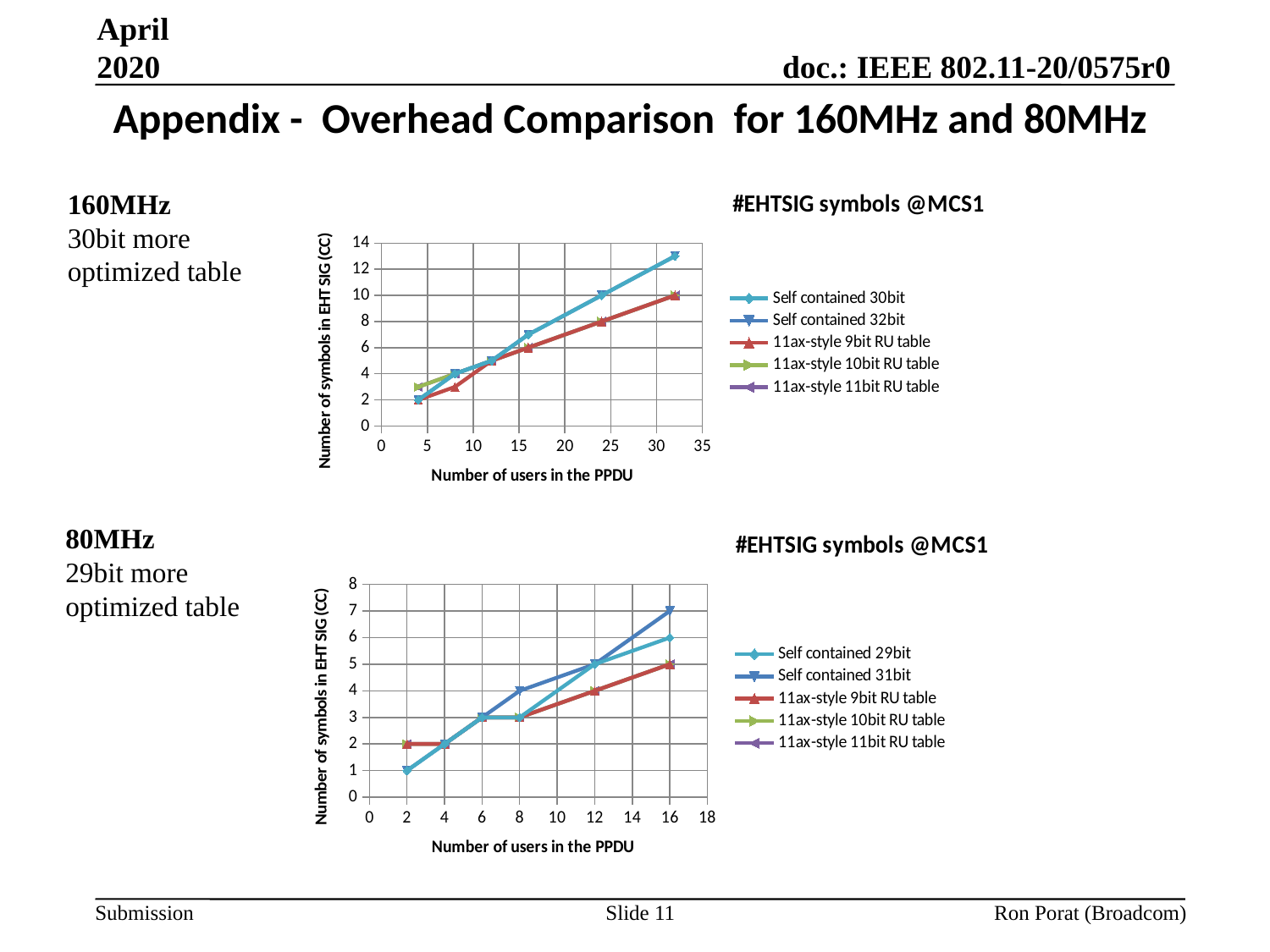
In the top chart (160MHz), what is the value of 11ax-style 9bit RU table at 24 users in the PPDU? 8 In the bottom chart (80MHz), what is the value of Self contained 31bit at 16 users in the PPDU? 7 In the top chart (160MHz), what is the value of Self contained 30bit at 24 users in the PPDU? 10 In the top chart (160MHz), which series has the highest value at 32 users in the PPDU? Self contained 30bit and Self contained 32bit (tied at 13) How many series does the legend of the bottom chart (80MHz) list? 5 In the bottom chart (80MHz), what is the value of 11ax-style 9bit RU table at 16 users in the PPDU? 5 In the top chart (160MHz), is the value of Self contained 30bit at 32 users greater or less than 12? greater In the bottom chart (80MHz), do the values of Self contained 29bit rise or fall as the number of users increases? rise In the bottom chart (80MHz), which is larger at 16 users: Self contained 31bit or Self contained 29bit? Self contained 31bit What is the title of the bottom chart (80MHz)? #EHTSIG symbols @MCS1 In the top chart (160MHz), what is the difference between Self contained 30bit and 11ax-style 9bit RU table at 24 users? 2 What type of chart is the top chart (160MHz) on the slide? line chart